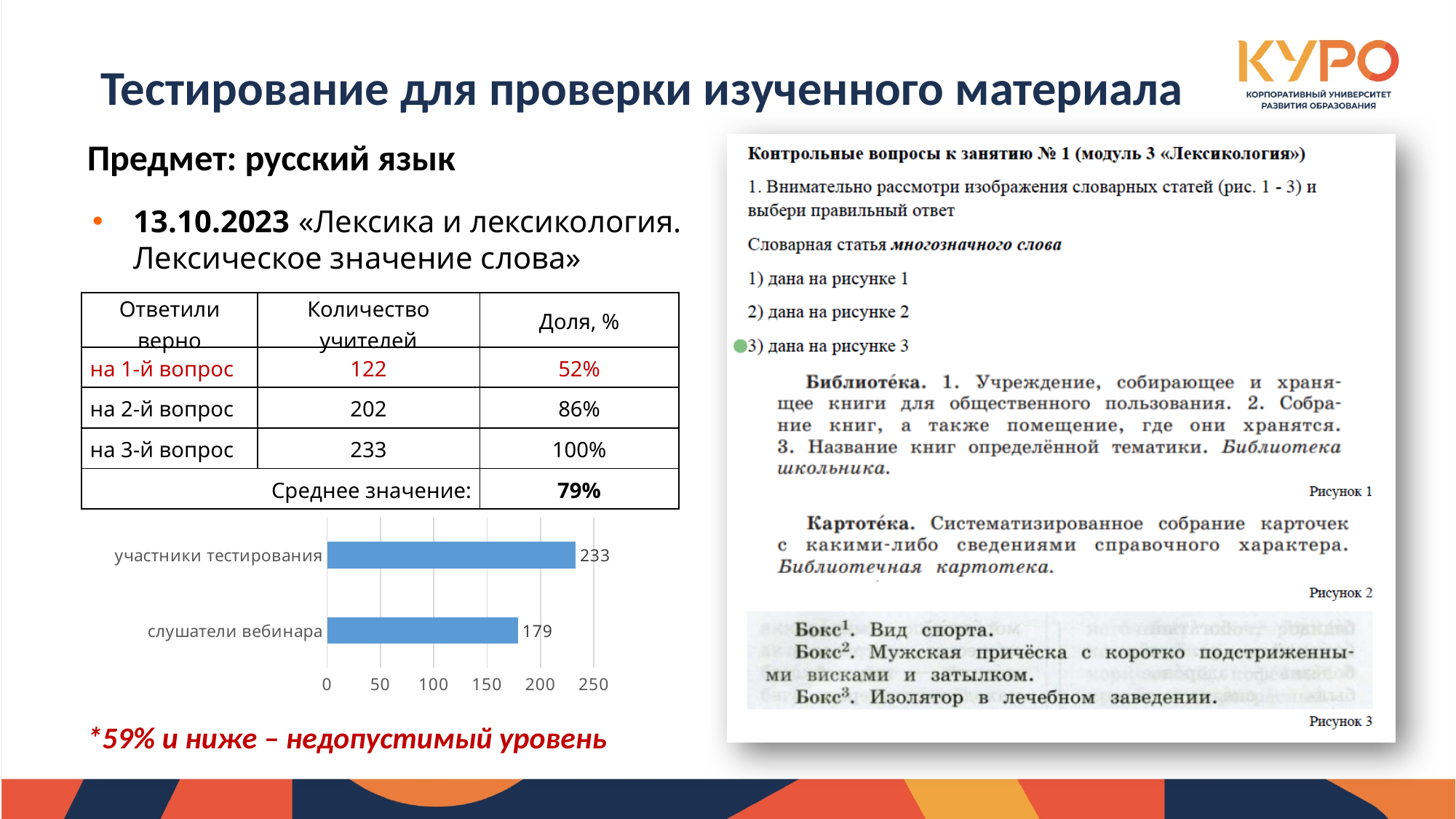
Is the value for «участники тестирования» greater or less than 200? greater Is the value for «слушатели вебинара» greater or less than 200? less What is the maximum value shown on the horizontal axis of the bar chart? 250 What colour are the bars in the chart? blue What kind of chart is shown on the slide? bar chart Which is larger: the value for «участники тестирования» or for «слушатели вебинара»? участники тестирования What is the difference between the values for «участники тестирования» and «слушатели вебинара»? 54 What is the value for «участники тестирования» in the bar chart? 233 Which category has the highest value in the bar chart? участники тестирования Which category has the lowest value in the bar chart? слушатели вебинара How many categories are shown in the bar chart? 2 What is the value for «слушатели вебинара» in the bar chart? 179